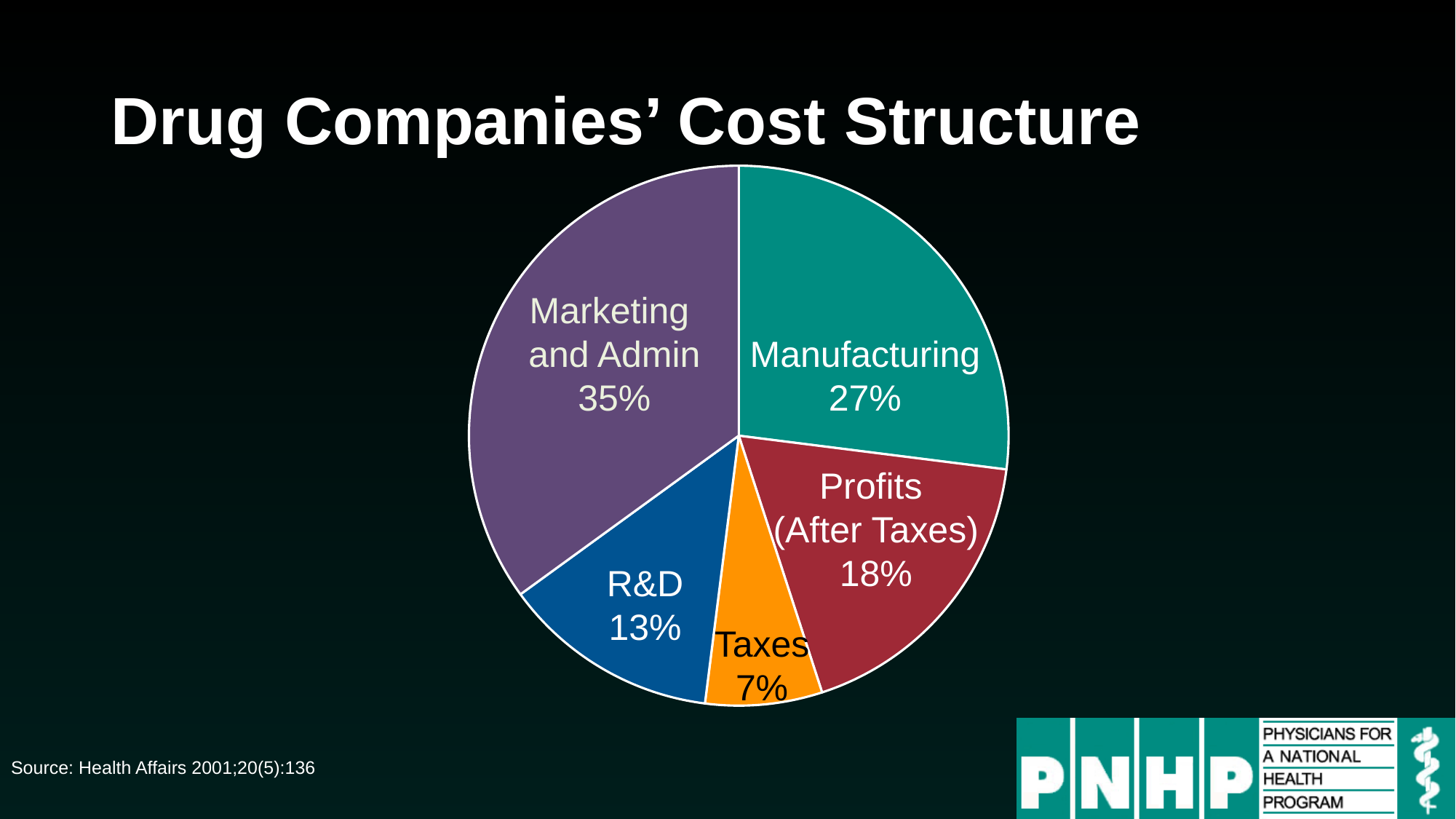
Which category has the smallest share of the pie? Taxes What percentage is shown for Taxes? 7% Which category has the largest share of the pie? Marketing and Admin What is the title of the chart? Drug Companies' Cost Structure What share of drug companies' cost structure is Marketing and Admin? 35% How many slices does the pie chart have? 5 What is the value shown for Profits (After Taxes)? 18% How many percentage points larger is Marketing and Admin than R&D? 22 What percentage is shown for R&D? 13% What kind of chart is shown on the slide? Pie chart Which is larger, Manufacturing or Profits (After Taxes)? Manufacturing What percentage does the Manufacturing slice represent? 27%